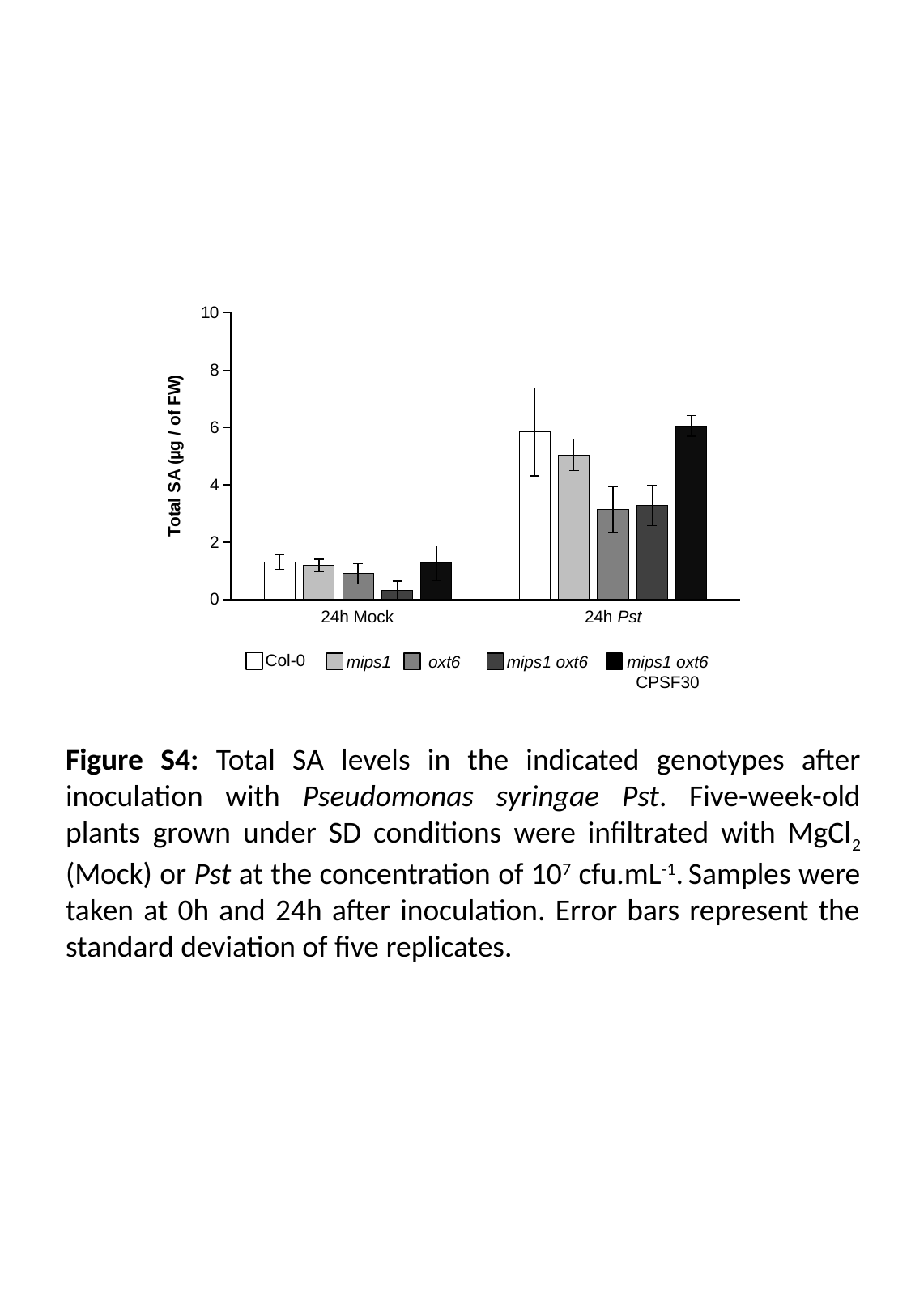
Which is larger at 24h Pst: the value for Col-0 or the value for oxt6? Col-0 Which genotype has the lowest value in the 24h Mock category? mips1 oxt6 How many categories are shown on the x axis? 2 Which is larger for mips1: the value at 24h Mock or the value at 24h Pst? 24h Pst Is the value for mips1 oxt6 at 24h Mock greater or less than 2? less Which colour represents mips1 oxt6 CPSF30 in the legend? black What kind of chart is shown on the slide? bar chart Is the value for mips1 oxt6 CPSF30 at 24h Pst greater or less than 4? greater What is the label of the y axis? Total SA (µg / of FW) How many series does the legend list? 5 Is the value for oxt6 at 24h Pst greater or less than 4? less